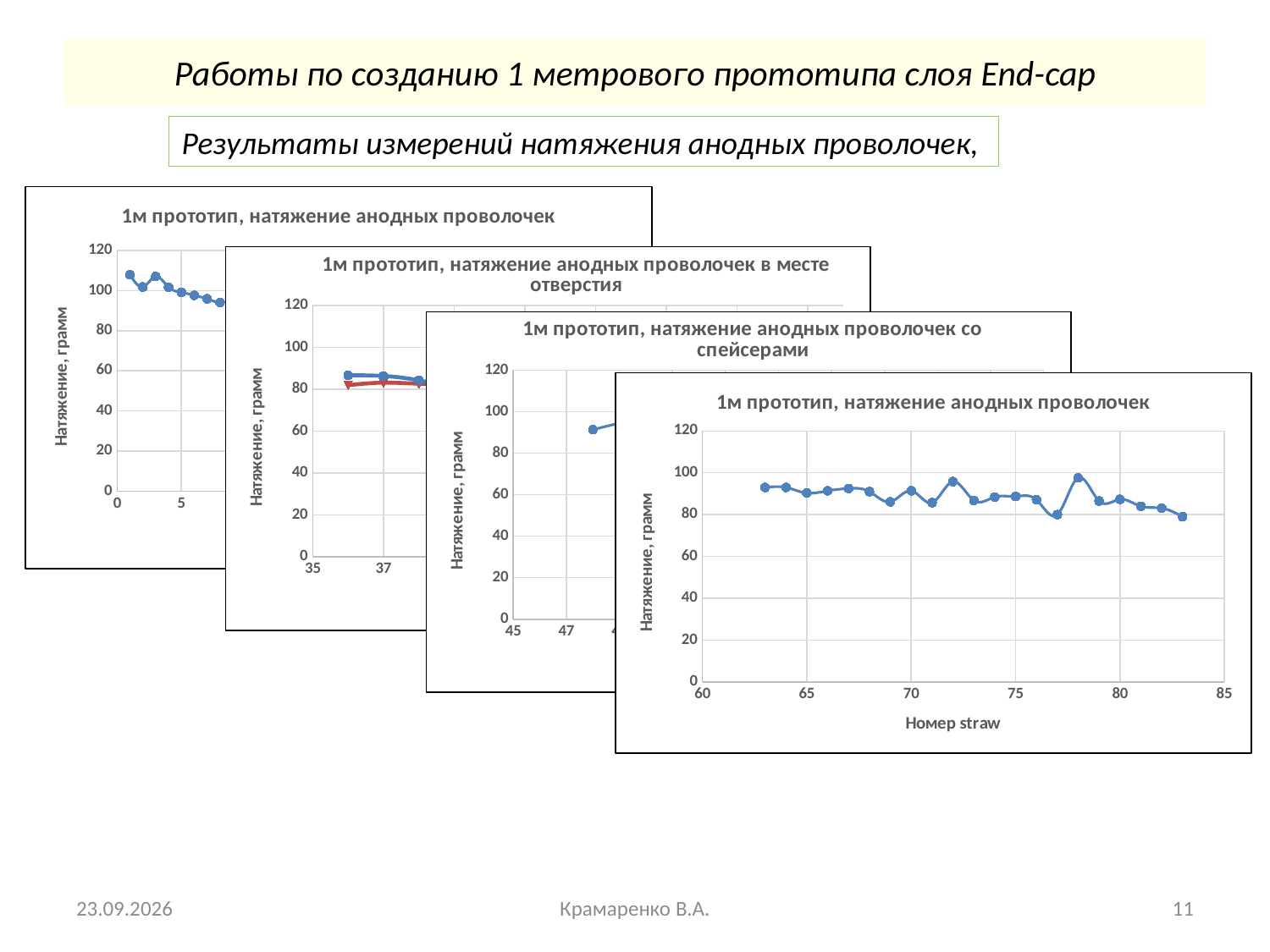
In the front chart (x axis 60 to 85), which straw number has the highest tension? 78 In the front chart (x axis 60 to 85), is the value for straw 63 greater or less than 80? greater In the front chart (x axis 60 to 85), which has the larger value: straw 78 or straw 69? straw 78 In the back-left chart (x axis starting at 0), is the value for the first point (straw 1) greater or less than 100? greater In the front chart (x axis 60 to 85), what is the label of the y axis? Натяжение, грамм In the chart titled '1м прототип, натяжение анодных проволочек в месте отверстия', how many lines (series) are plotted? 2 In the front chart (x axis 60 to 85), do the values overall rise or fall from straw 63 to straw 83? fall In the front chart (x axis 60 to 85), how many data points are plotted? 21 In the front chart (x axis 60 to 85), is the value for straw 78 greater or less than 80? greater What kind of chart is the front chart titled '1м прототип, натяжение анодных проволочек' with x axis 'Номер straw' from 60 to 85? line chart How many charts are shown on the slide? 4